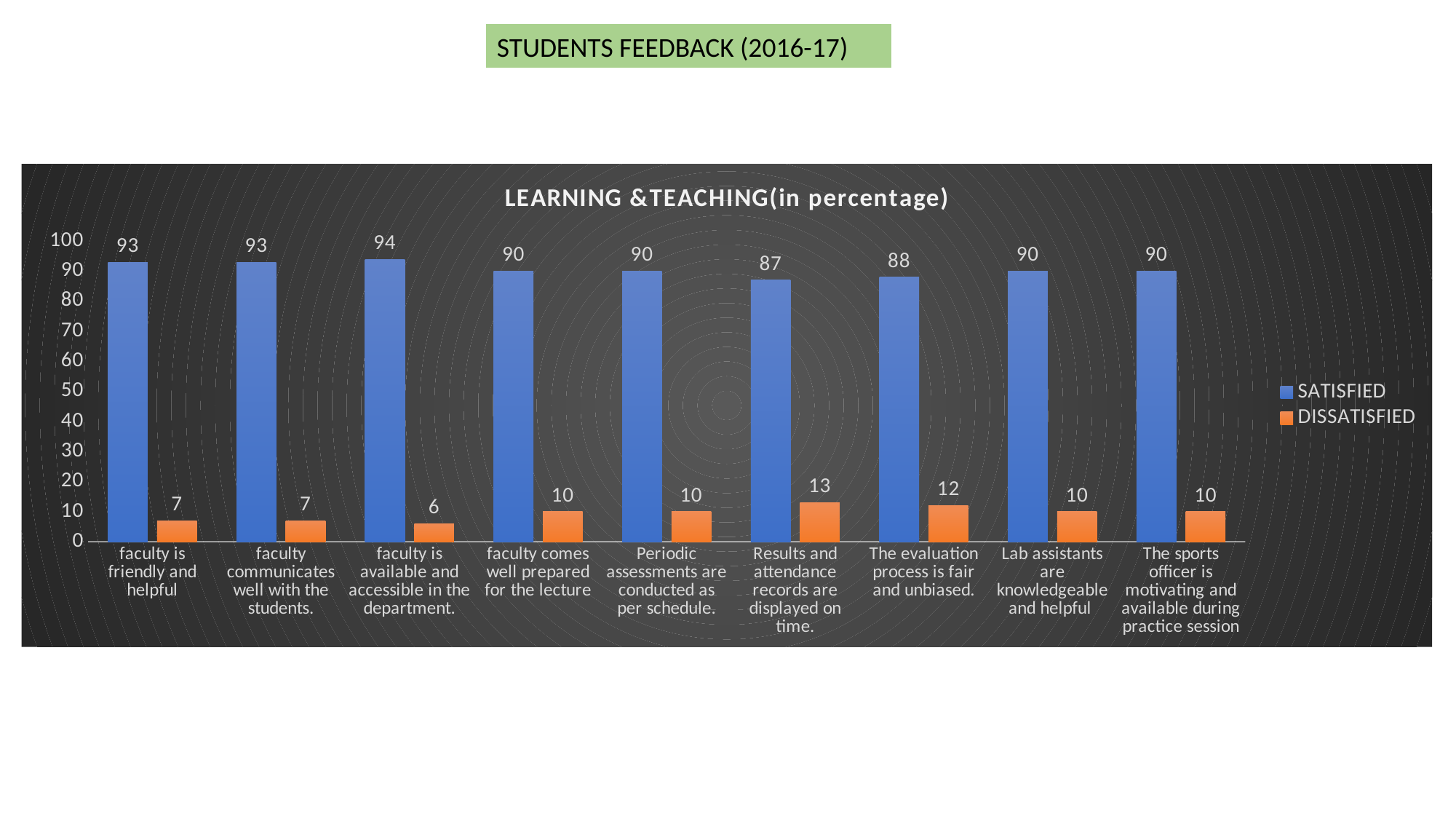
What is the DISSATISFIED value for 'Results and attendance records are displayed on time.'? 13 What is the SATISFIED value for 'faculty is available and accessible in the department.'? 94 Which category has the highest SATISFIED value? faculty is available and accessible in the department. Which category has the lowest SATISFIED value? Results and attendance records are displayed on time. What kind of chart is shown? bar chart How many categories are shown on the x axis? 9 Which is larger: the DISSATISFIED value for 'The evaluation process is fair and unbiased.' or for 'faculty comes well prepared for the lecture'? The evaluation process is fair and unbiased. How many series does the legend list? 2 Which category has the lowest DISSATISFIED value? faculty is available and accessible in the department. What is the difference between the SATISFIED and DISSATISFIED values for 'Lab assistants are knowledgeable and helpful'? 80 What is the SATISFIED value for 'The evaluation process is fair and unbiased.'? 88 What is the title of the chart? LEARNING &TEACHING(in percentage)